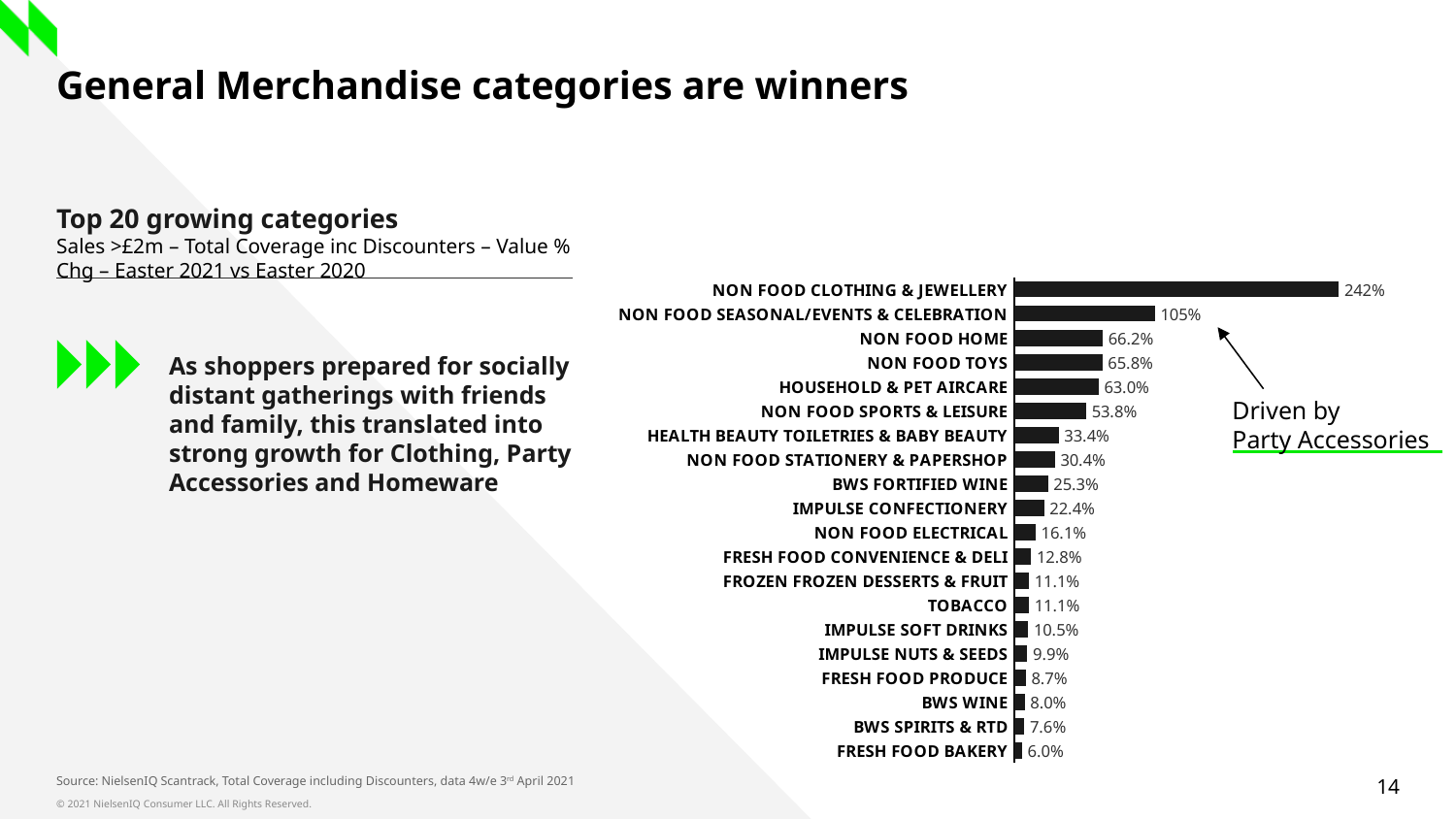
What is the value for FRESH FOOD BAKERY? 6.0% What is the value for HOUSEHOLD & PET AIRCARE? 63.0% What is the value for BWS FORTIFIED WINE? 25.3% How many categories are shown in the chart? 20 What is the value for NON FOOD CLOTHING & JEWELLERY? 242% According to the annotation, what is the growth in NON FOOD SEASONAL/EVENTS & CELEBRATION driven by? Party Accessories Which is larger, the value for IMPULSE CONFECTIONERY or the value for NON FOOD ELECTRICAL? IMPULSE CONFECTIONERY What is the difference between the values for NON FOOD CLOTHING & JEWELLERY and NON FOOD SEASONAL/EVENTS & CELEBRATION? 137% Which category has the highest value? NON FOOD CLOTHING & JEWELLERY What kind of chart is shown on the slide? Bar chart Which category has the lowest value? FRESH FOOD BAKERY What is the difference between the values for NON FOOD HOME and NON FOOD TOYS? 0.4%